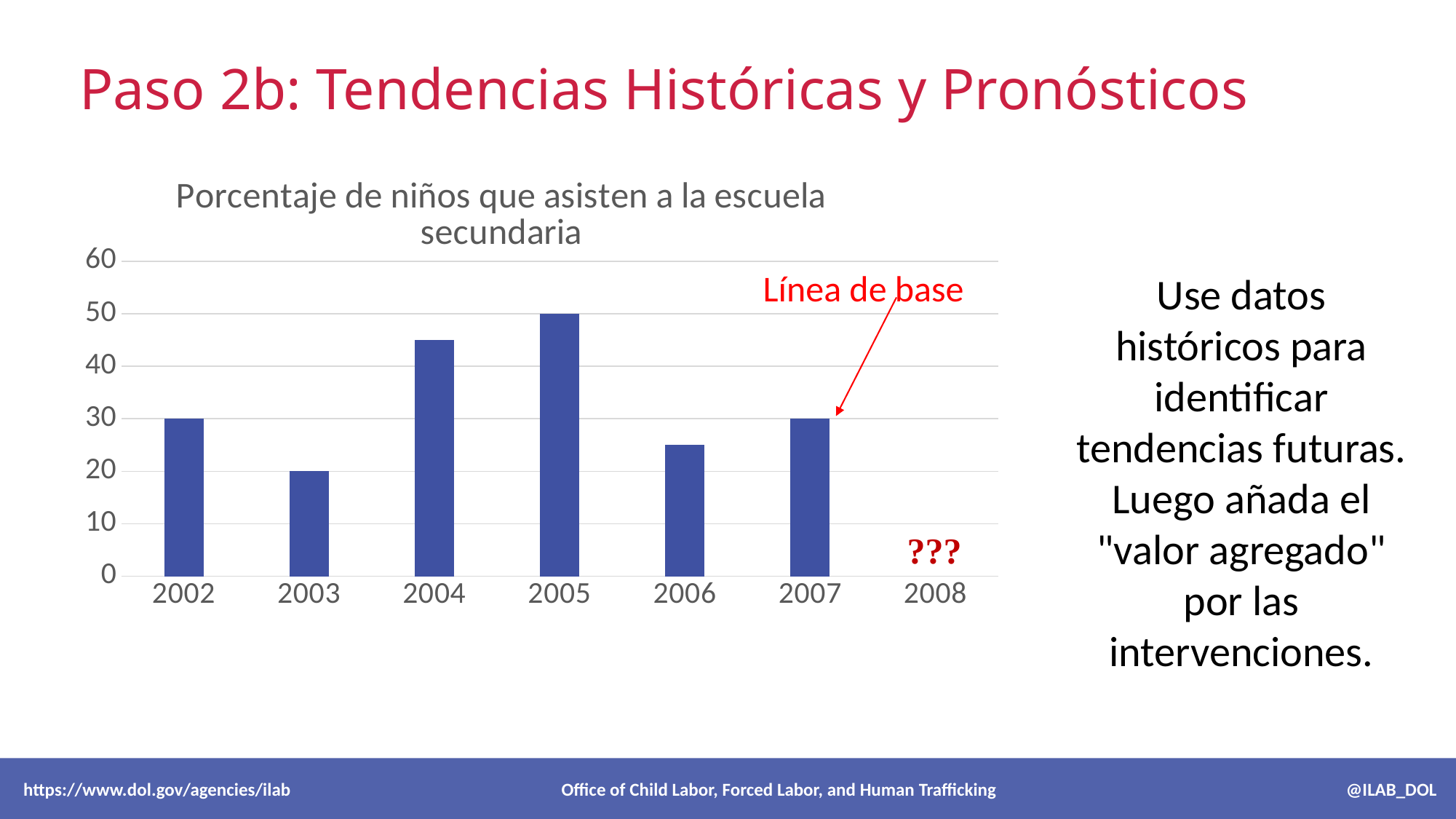
Which year's bar is labelled "Línea de base"? 2007 What is the title of the chart? Porcentaje de niños que asisten a la escuela secundaria What is the value for 2003? 20 Is the value for 2004 greater or less than 40? greater What is the difference between the values for 2005 and 2003? 30 Which is larger, the value for 2004 or the value for 2006? 2004 Which year with a bar has the lowest value? 2003 How many years are labelled on the x axis? 7 What is the value for 2005? 50 What is the value for 2002? 30 Which year has the highest value? 2005 What type of chart is shown on the slide? bar chart